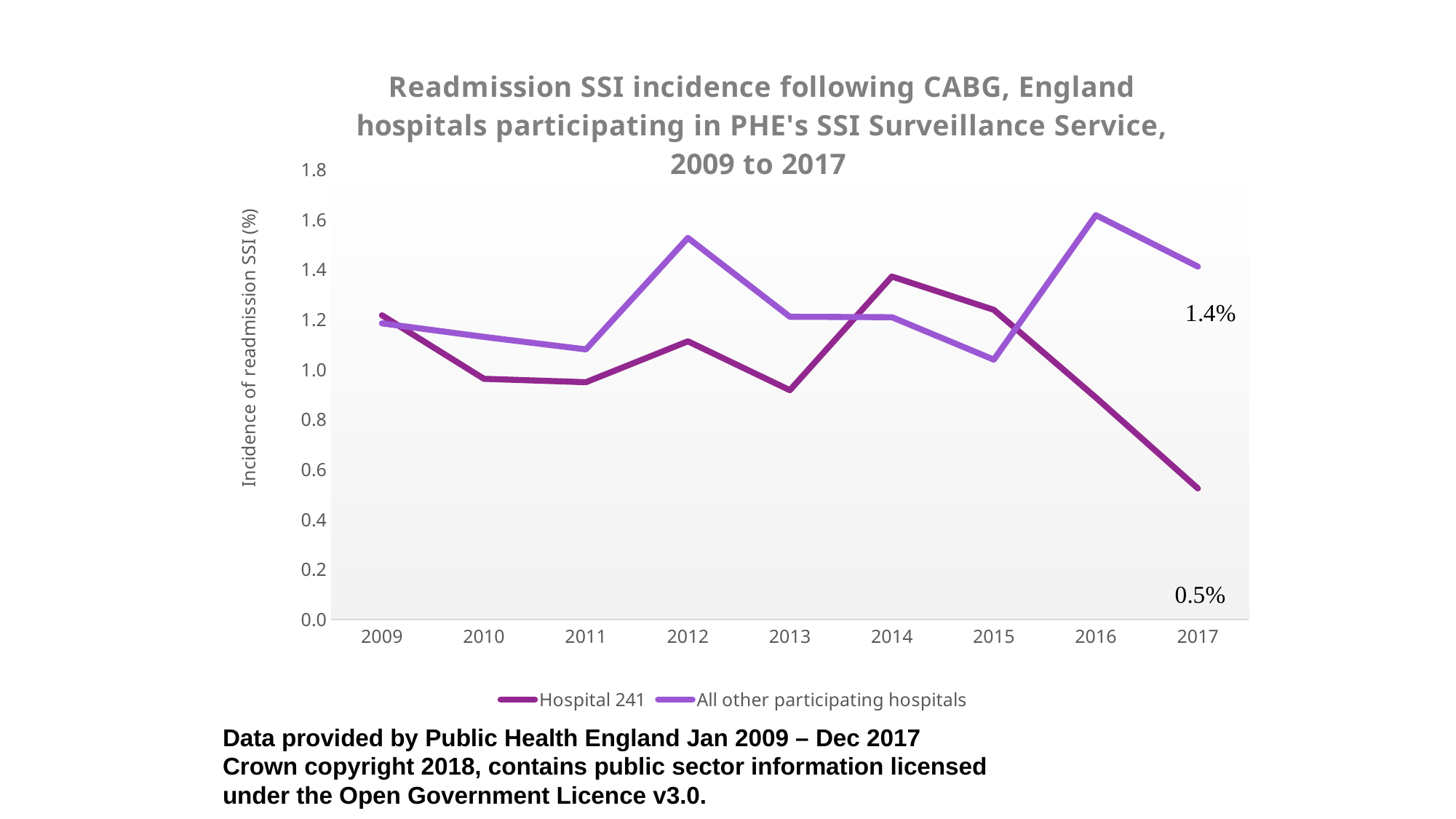
Does the Hospital 241 line rise or fall from 2015 to 2017? fall In 2017, which series has the higher value, Hospital 241 or All other participating hospitals? All other participating hospitals What is the readmission SSI incidence for All other participating hospitals in 2017? 1.4% In which year does the Hospital 241 line reach its lowest value? 2017 In which year does the All other participating hospitals line reach its highest value? 2016 How many years are plotted along the x axis? 9 What is the difference between the 2017 values for All other participating hospitals and Hospital 241? 0.9% What is the readmission SSI incidence for Hospital 241 in 2017? 0.5% How many series does the legend list? 2 What type of chart is shown on the slide? line chart Is the value for Hospital 241 in 2013 greater or less than 1.0? less What is the label on the vertical axis? Incidence of readmission SSI (%)